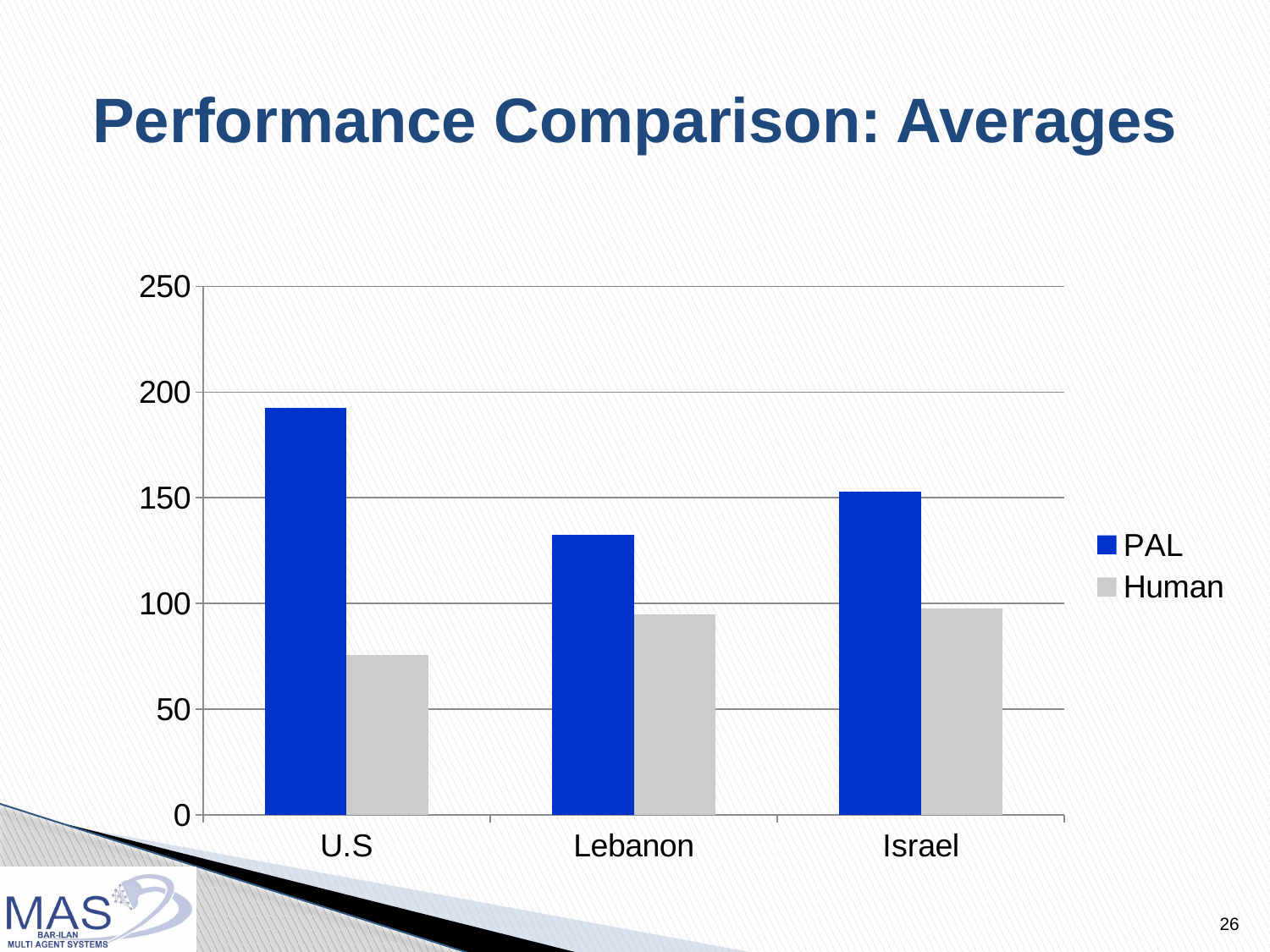
Which category has the lowest PAL value? Lebanon What kind of chart is shown on the slide? bar chart Is the Human value for U.S greater or less than 100? less What is the title of the chart slide? Performance Comparison: Averages How many series does the legend list? 2 Which category has the highest PAL value? U.S For Lebanon, which is larger, the PAL value or the Human value? PAL How many categories are shown on the x axis? 3 Is the PAL value for Lebanon greater or less than 150? less Is the PAL value for U.S greater or less than 150? greater Which category has the lowest Human value? U.S